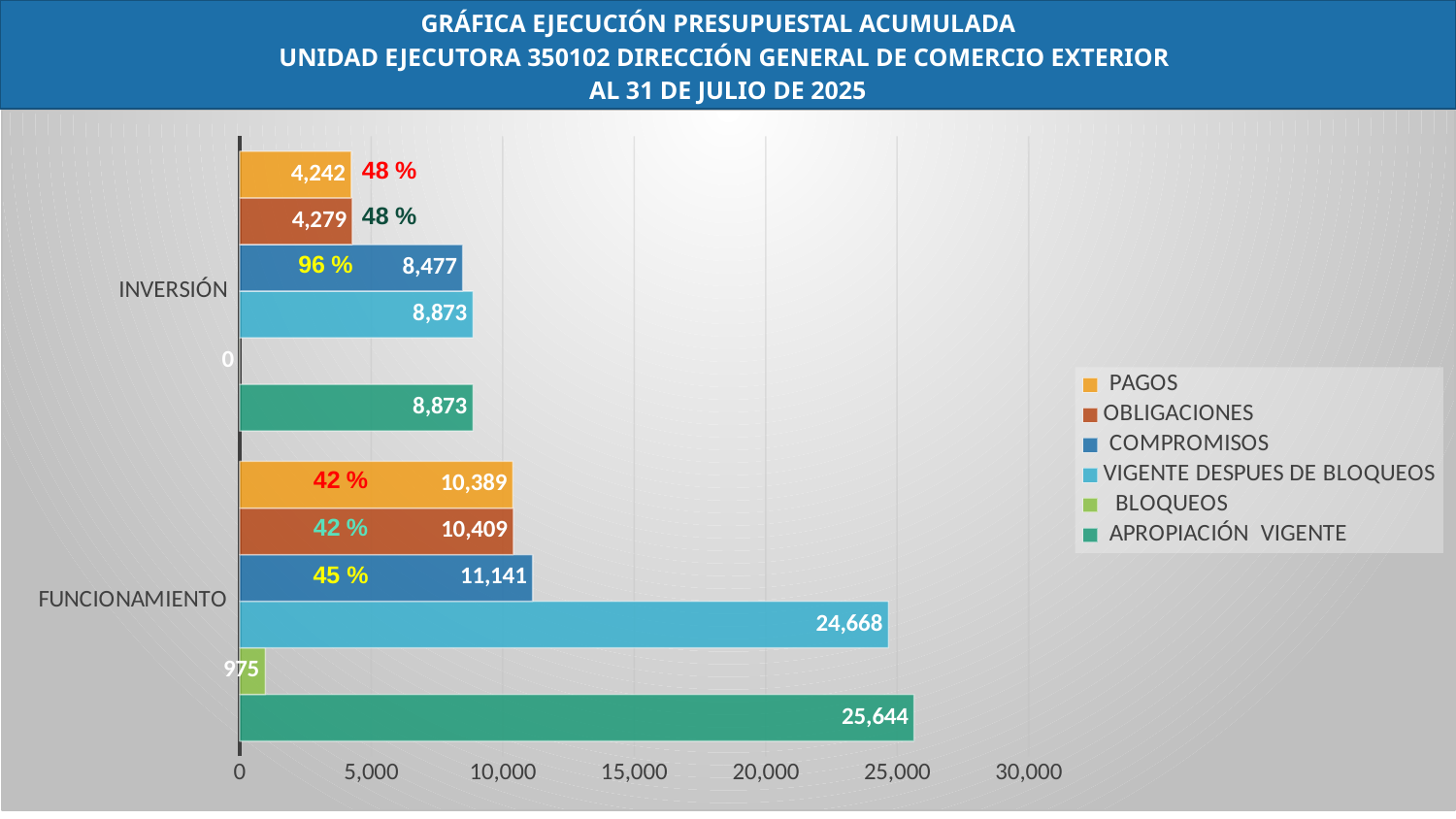
Which is larger: OBLIGACIONES for FUNCIONAMIENTO or COMPROMISOS for FUNCIONAMIENTO? COMPROMISOS for FUNCIONAMIENTO Which series has the lowest value for INVERSIÓN? BLOQUEOS What percentage is shown next to the COMPROMISOS bar for INVERSIÓN? 96 % What is the difference between APROPIACIÓN VIGENTE and VIGENTE DESPUES DE BLOQUEOS for FUNCIONAMIENTO? 976 What is the value of COMPROMISOS for INVERSIÓN? 8,477 What is the value of VIGENTE DESPUES DE BLOQUEOS for FUNCIONAMIENTO? 24,668 What is the value of PAGOS for INVERSIÓN? 4,242 Which series has the highest value for FUNCIONAMIENTO? APROPIACIÓN VIGENTE What is the value of BLOQUEOS for FUNCIONAMIENTO? 975 What kind of chart is shown on the slide? Bar chart What is the value of APROPIACIÓN VIGENTE for FUNCIONAMIENTO? 25,644 How many series does the legend list? 6